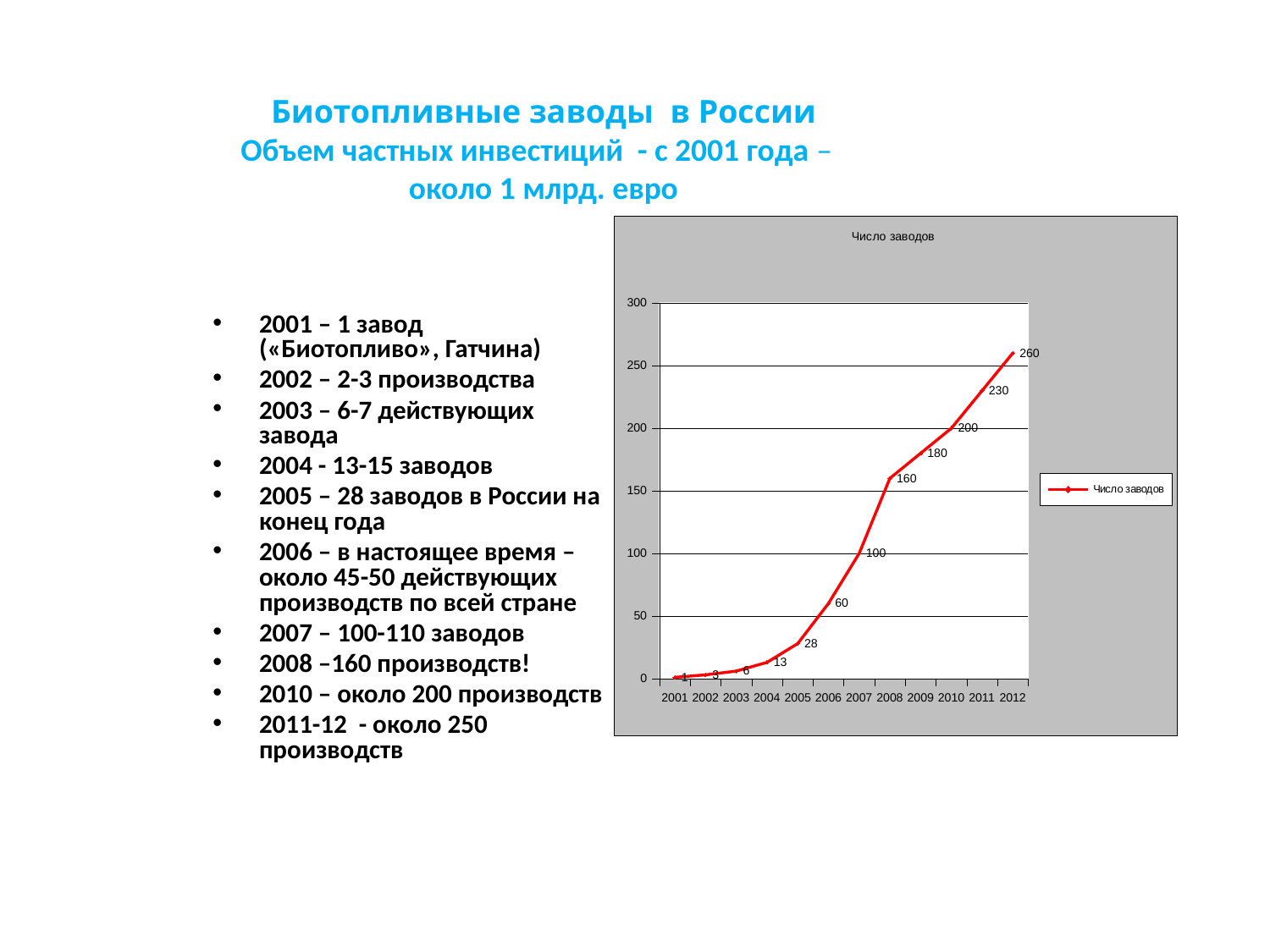
Which year has the highest value in the chart? 2012 What is the value for 2008 in the chart? 160 What is the title of the chart? Число заводов How many series does the chart legend list? 1 What is the value for 2012 in the chart? 260 Which year has the lowest value in the chart? 2001 Which is larger, the value for 2007 or the value for 2009? 2009 How many years are plotted on the x axis of the chart? 12 What is the difference between the values for 2012 and 2010? 60 Do the values rise or fall from 2001 to 2012? Rise What type of chart is shown on the slide? Line chart What is the value for 2005 in the chart? 28